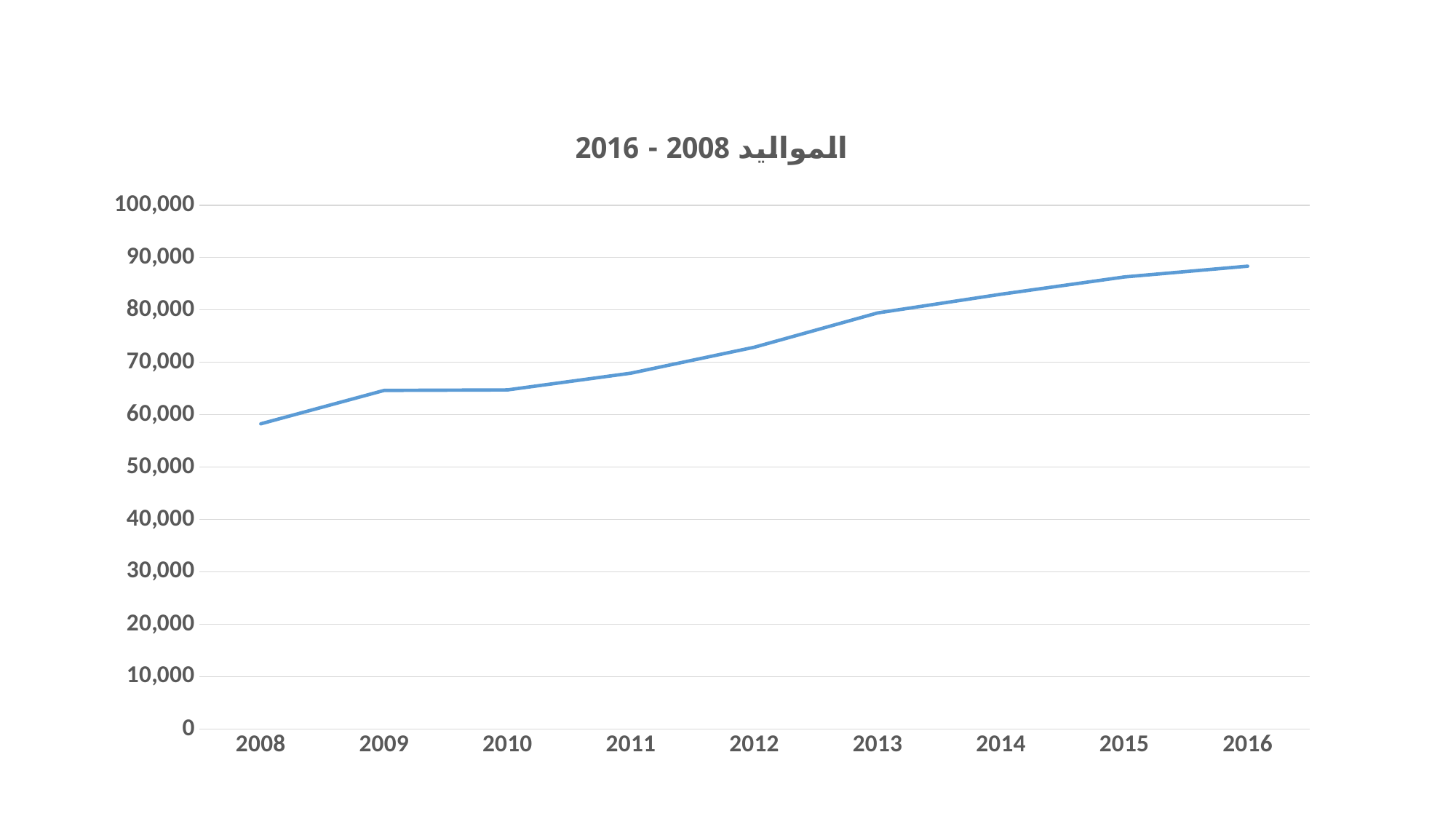
How many years are plotted along the x axis? 9 Is the value for 2011 greater or less than 70,000? less Which year has the lowest value? 2008 What is the title of the chart? المواليد 2008 - 2016 What kind of chart is shown on the slide? line chart Which year has the highest value? 2016 Do the values generally rise or fall from 2008 to 2016? rise Is the value for 2015 greater or less than 90,000? less Is the value for 2013 greater or less than 70,000? greater Which is larger, the value for 2013 or the value for 2010? 2013